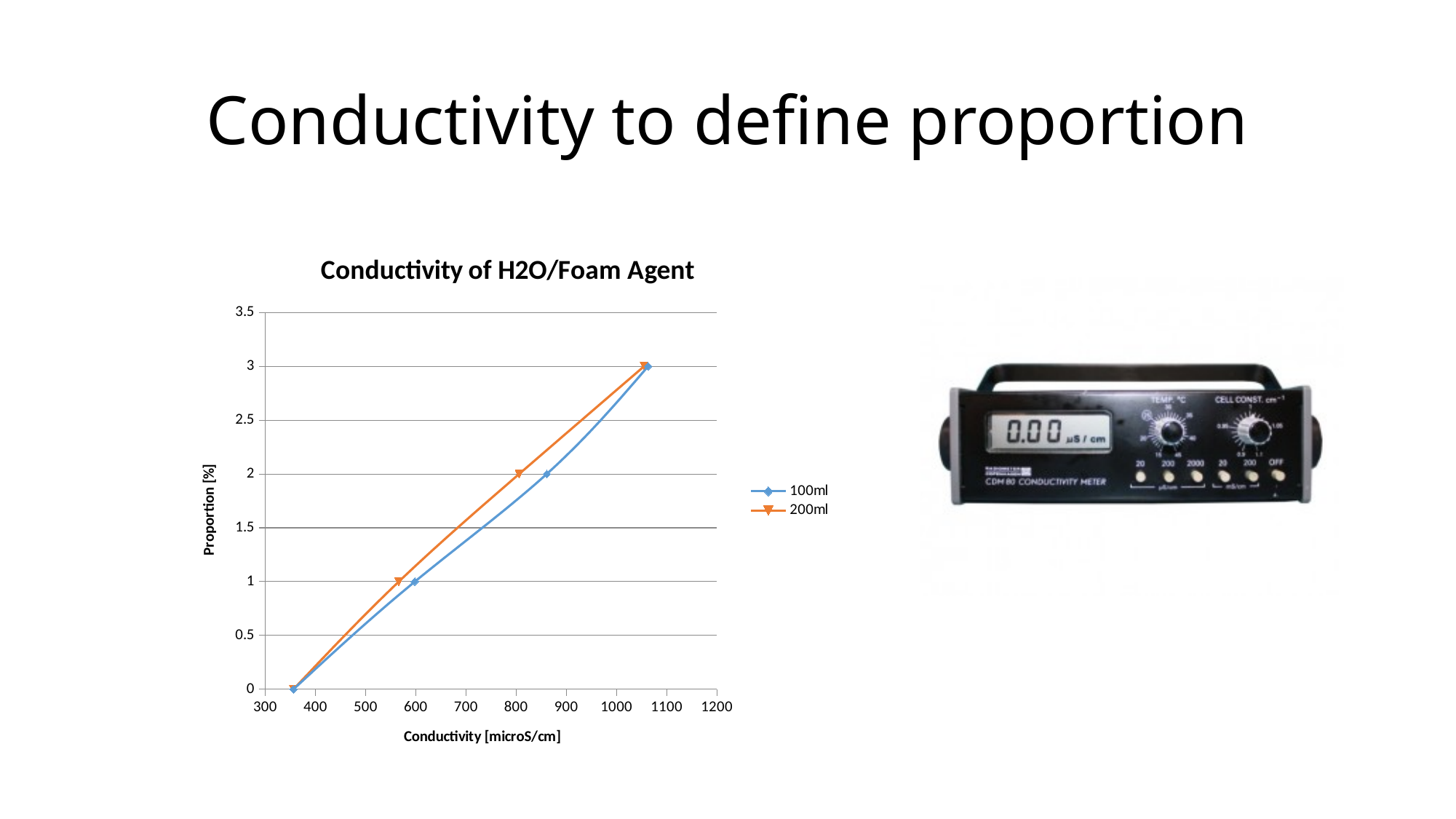
Is the conductivity of the 100ml series at a proportion of 2% greater or less than 800? greater What is the highest proportion value reached by the 200ml series? 3 What is the title of the chart? Conductivity of H2O/Foam Agent What kind of chart is shown on the slide? line chart Does the proportion rise or fall as conductivity increases along the x axis? rise What are the two series named in the chart legend? 100ml and 200ml What is the label of the x axis? Conductivity [microS/cm] At a proportion of 2%, which series has the lower conductivity, 100ml or 200ml? 200ml How many series does the chart legend list? 2 How many data points does the 100ml series have? 4 Is the conductivity of the 200ml series at a proportion of 1% greater or less than 600? less What is the lowest proportion value in the 100ml series? 0